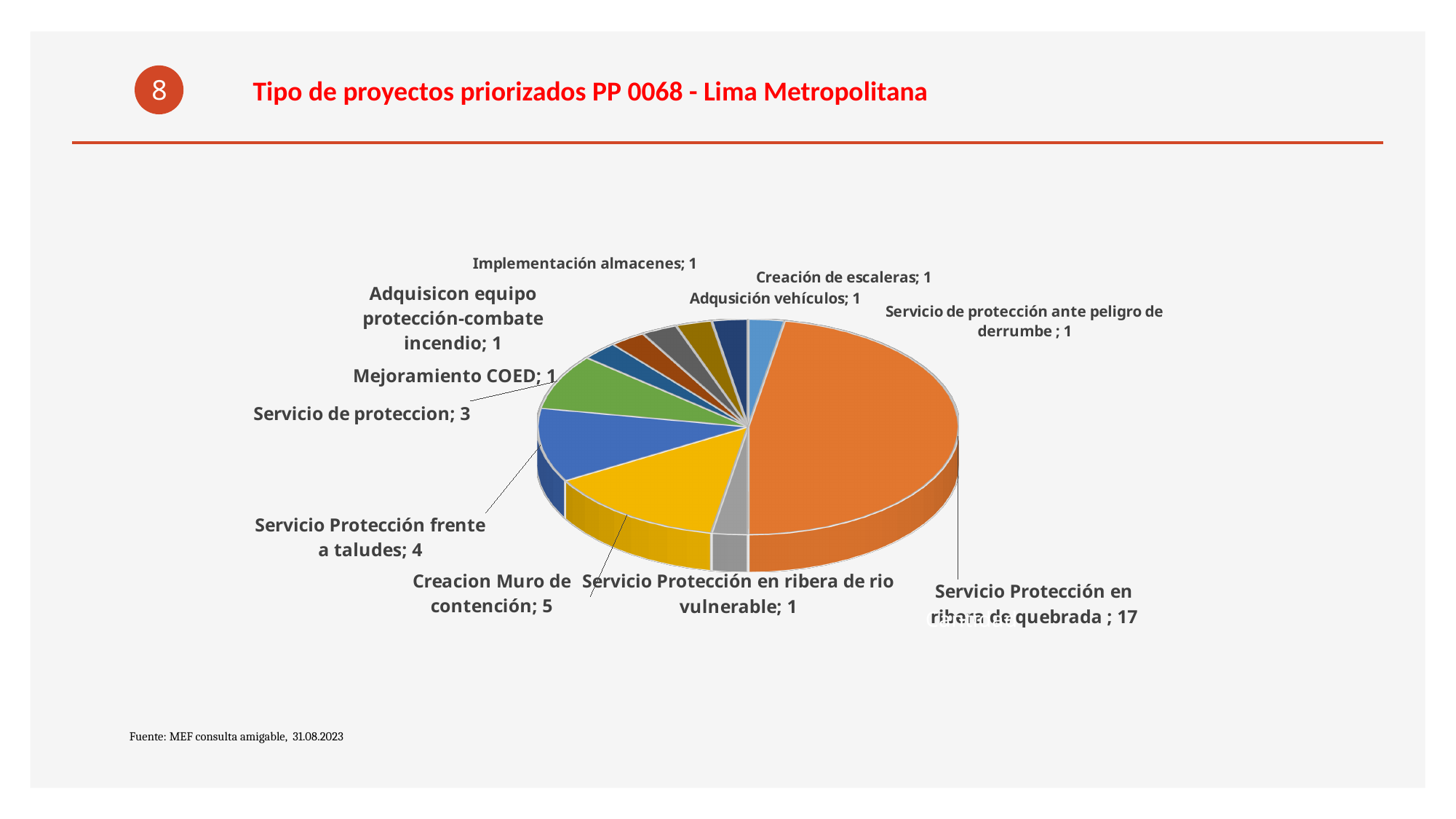
What is the value shown for 'Mejoramiento COED'? 1 Which project type has the largest slice of the pie? Servicio Protección en ribera de quebrada How many project types (slices) are shown in the pie chart? 11 What is the difference between the values for 'Servicio Protección en ribera de quebrada' and 'Creacion Muro de contención'? 12 What is the source cited at the bottom of the slide? MEF consulta amigable, 31.08.2023 What is the value shown for 'Servicio de proteccion'? 3 What is the title of the chart on the slide? Tipo de proyectos priorizados PP 0068 - Lima Metropolitana What type of chart is shown on the slide? Pie chart Which is larger, the value for 'Creacion Muro de contención' or the value for 'Servicio Protección frente a taludes'? Creacion Muro de contención What is the value shown for 'Creacion Muro de contención'? 5 What is the value shown for 'Servicio Protección frente a taludes'? 4 How many projects are labelled for 'Servicio Protección en ribera de quebrada'? 17